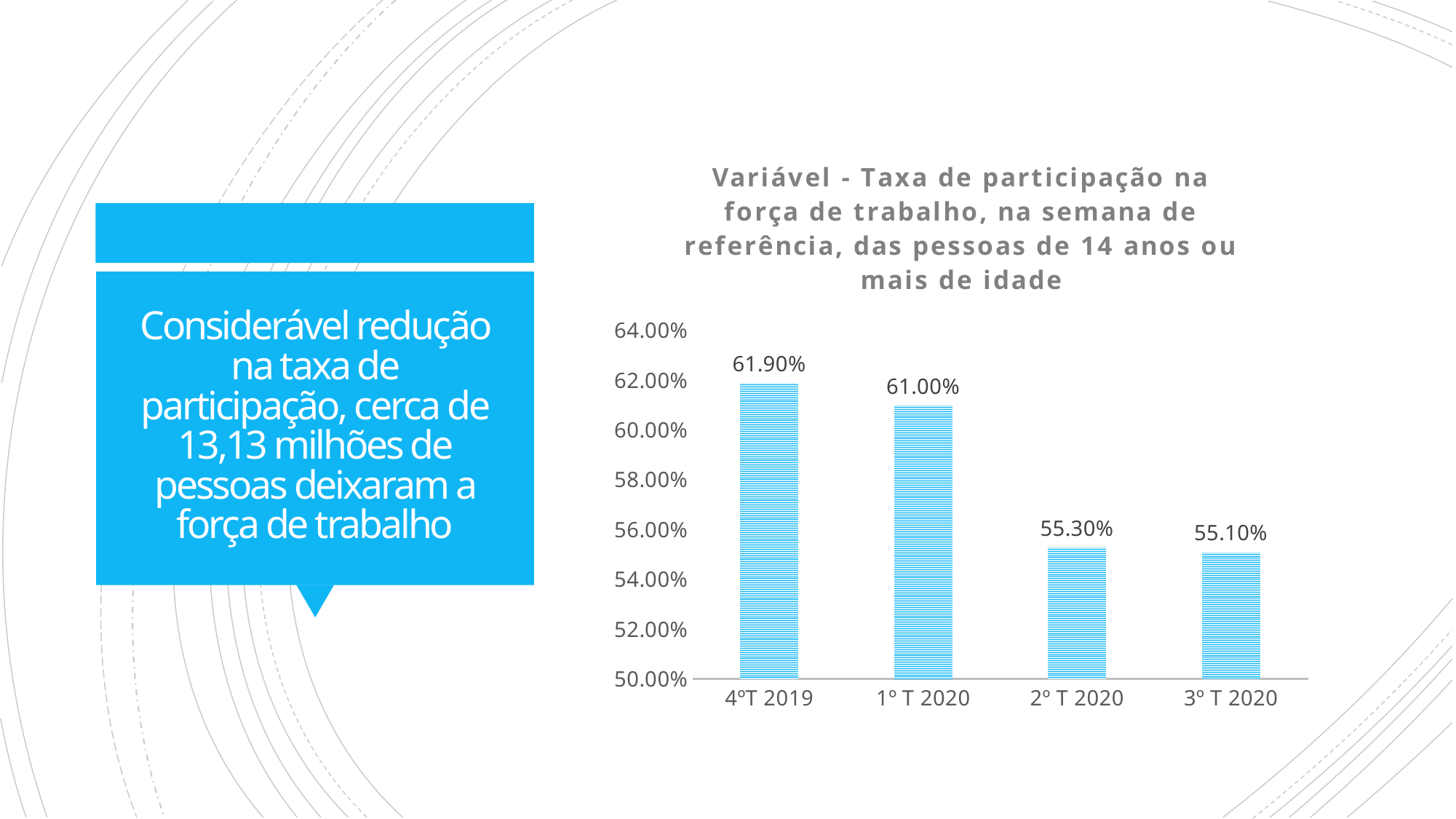
What is the difference between the values for 1º T 2020 and 2º T 2020? 5.70% Do the values rise or fall from 4ºT 2019 to 3º T 2020? Fall Which category has the highest value? 4ºT 2019 What is the value for 3º T 2020? 55.10% What is the value for 2º T 2020? 55.30% How many categories are shown on the x axis? 4 What is the difference between the values for 4ºT 2019 and 3º T 2020? 6.80% Which category has the lowest value? 3º T 2020 Which is larger, the value for 1º T 2020 or the value for 2º T 2020? 1º T 2020 What kind of chart is shown on the slide? Bar chart What is the value for 4ºT 2019? 61.90% What is the value for 1º T 2020? 61.00%